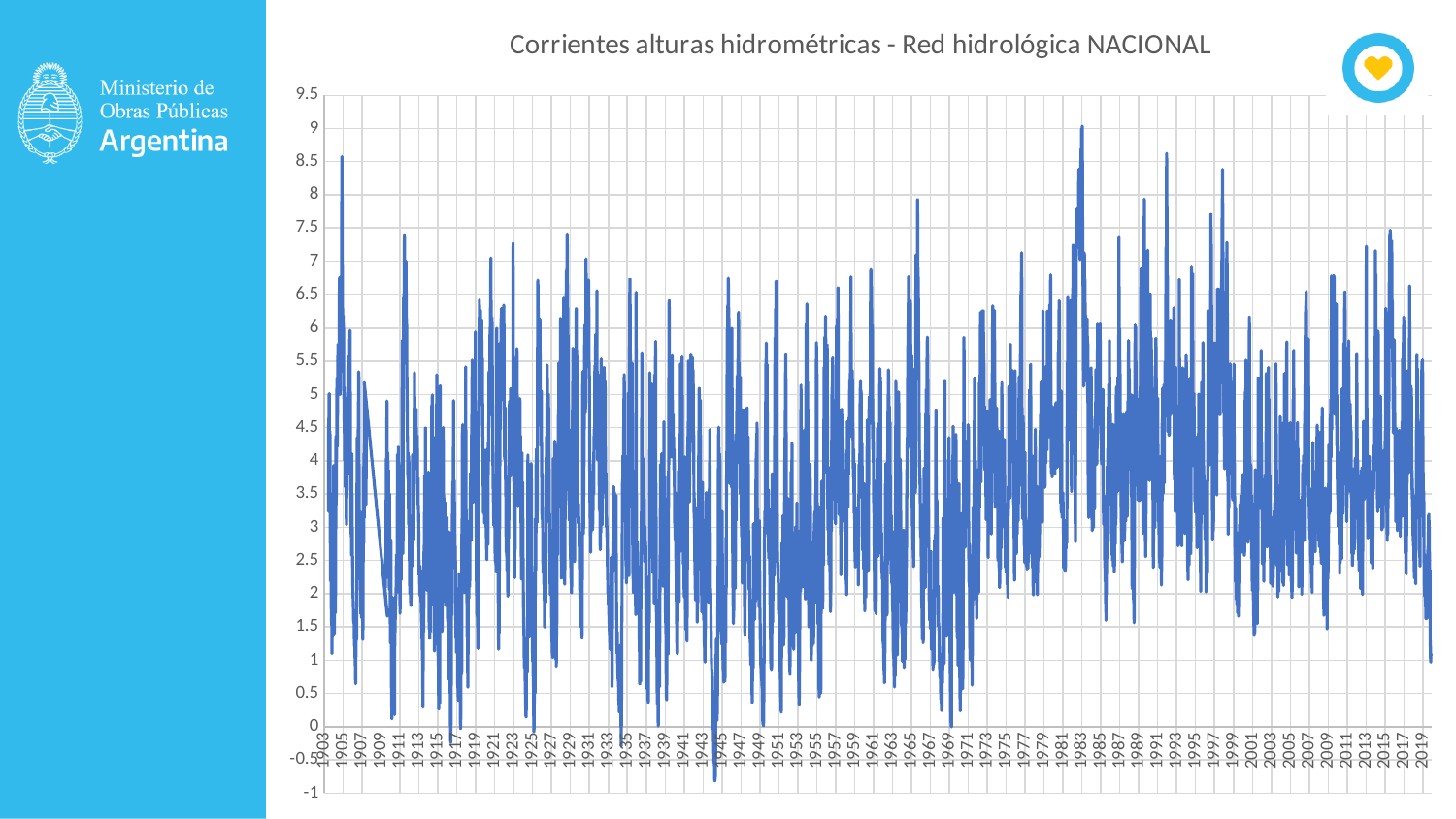
What is the highest value shown on the vertical axis? 9.5 Is the peak near 1965 greater or less than 7.5? greater Around which year does the line reach its highest value? 1983 What type of chart is shown on the slide? line chart What is the last year shown on the horizontal axis? 2019 Is the peak near 1991 greater or less than 8? greater What is the first year shown on the horizontal axis? 1903 Is the lowest point of the line, around 1944-1945, greater or less than 0? less What is the title of the chart? Corrientes alturas hidrométricas - Red hidrológica NACIONAL How many lines (series) are plotted on the chart? 1